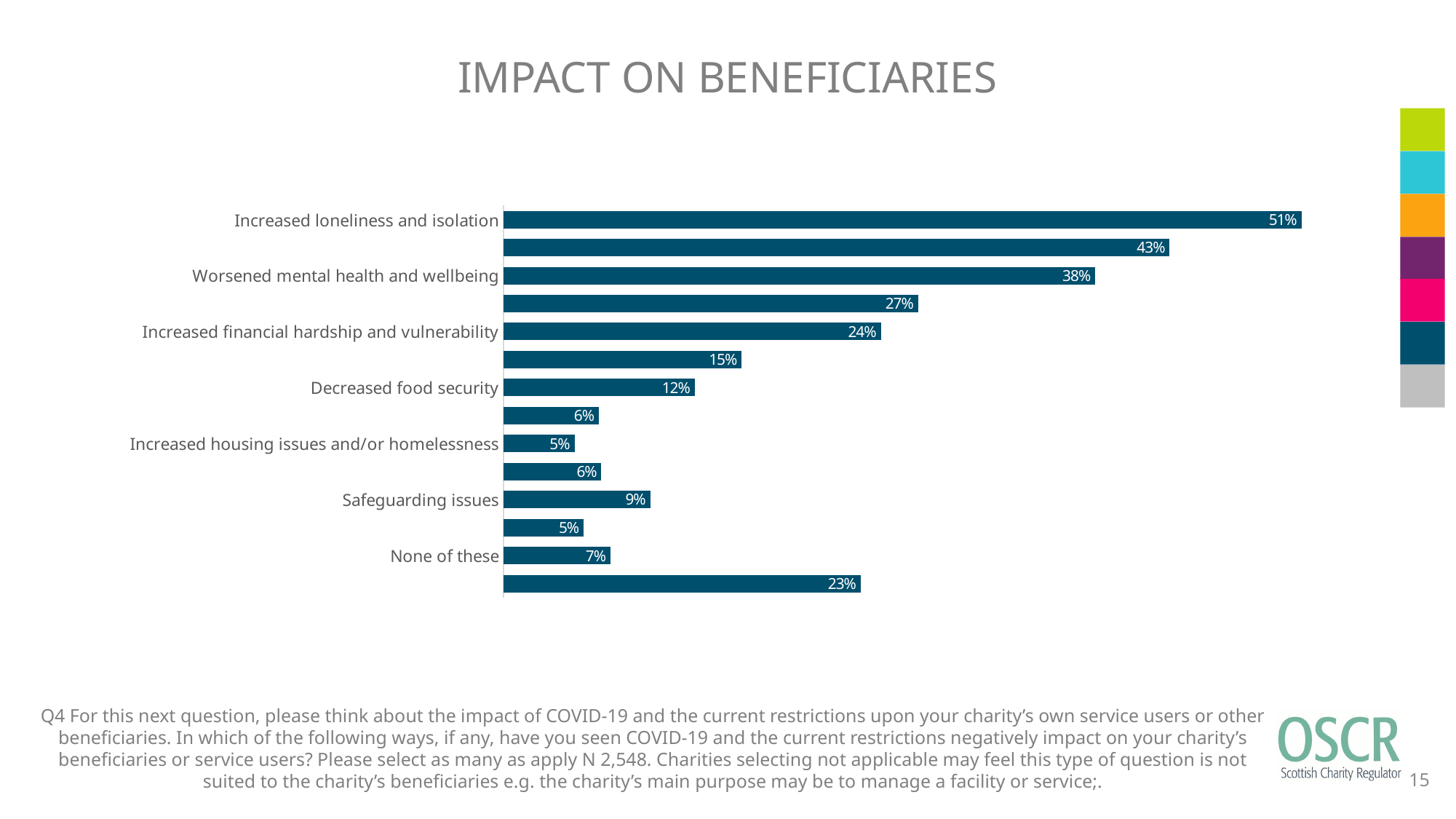
What is the value for None of these? 7% What percentage is shown for Increased financial hardship and vulnerability? 24% What is the value for Decreased food security? 12% Which labelled category has the highest value? Increased loneliness and isolation What is the difference in percentage points between Increased financial hardship and vulnerability and Decreased food security? 12 Which is larger, the value for Safeguarding issues or the value for None of these? Safeguarding issues What is the value for Worsened mental health and wellbeing? 38% What percentage is shown for Increased loneliness and isolation? 51% How many bars are plotted in the chart? 14 What kind of chart is shown on the slide? Bar chart What is the difference in percentage points between Increased loneliness and isolation and Worsened mental health and wellbeing? 13 What percentage is shown for Safeguarding issues? 9%